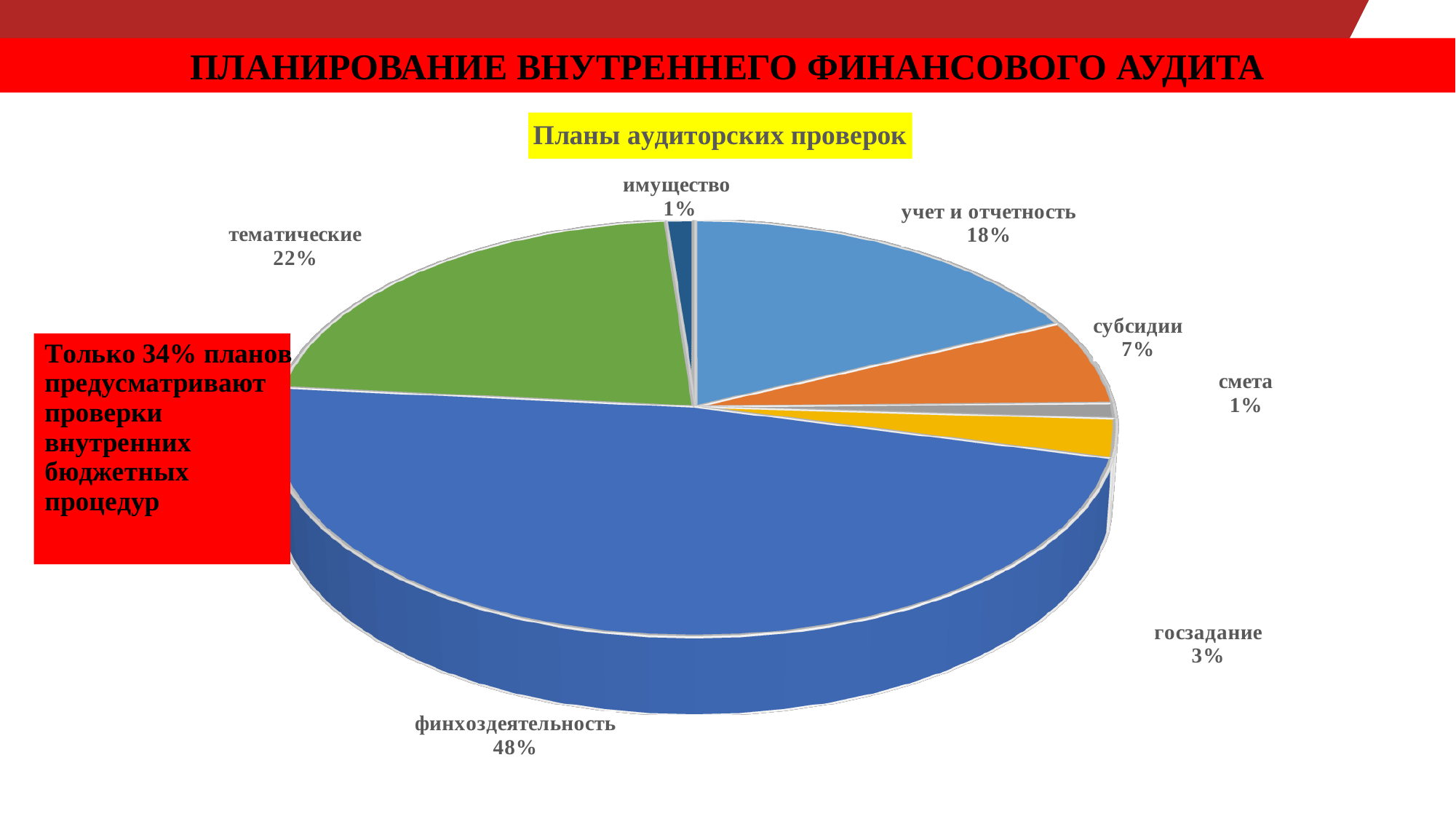
What share of the pie does "тематические" have? 22% What is the difference between the shares of "финхоздеятельность" and "тематические"? 26% What is the value shown for "учет и отчетность"? 18% How many categories (slices) does the pie chart have? 7 What is the difference between the shares of "учет и отчетность" and "субсидии"? 11% What share of the pie does "финхоздеятельность" have? 48% What type of chart is shown on the slide? Pie chart Which category has the largest share of the pie? финхоздеятельность What is the value shown for "субсидии"? 7% What is the value shown for "госзадание"? 3% What is the title of the chart? Планы аудиторских проверок Which is larger, "тематические" or "учет и отчетность"? тематические